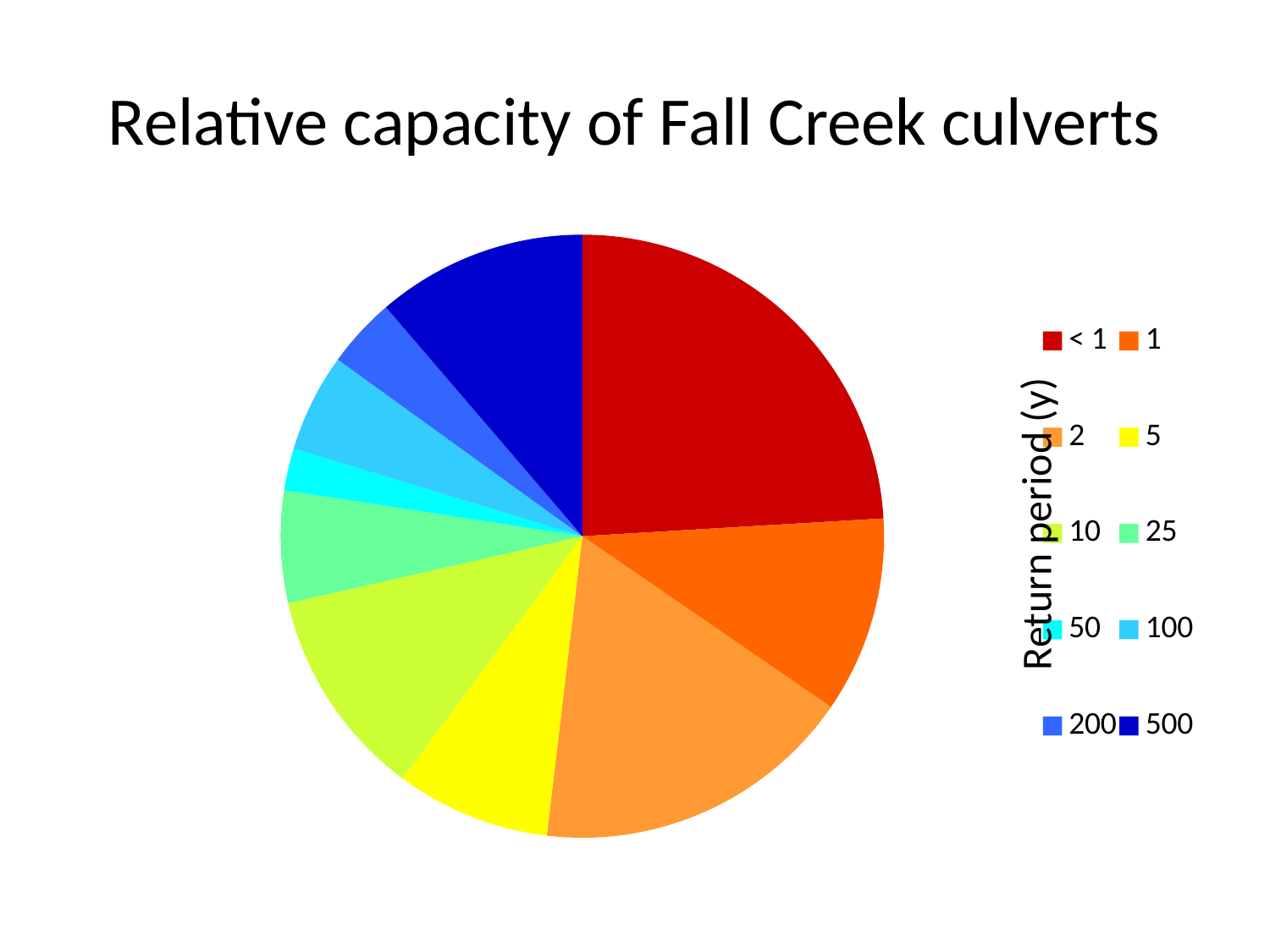
Which slice is larger, the one for return period 500 or the one for return period 200? 500 Which slice is larger, the one for return period < 1 or the one for return period 2? < 1 Which slice is larger, the one for return period 10 or the one for return period 5? 10 How many slices does the pie chart have? 10 What kind of chart is shown on the slide? pie chart Which return period category has the largest slice of the pie? < 1 What is the title of the legend? Return period (y) Which return period category has the smallest slice of the pie? 50 What is the title of the chart? Relative capacity of Fall Creek culverts